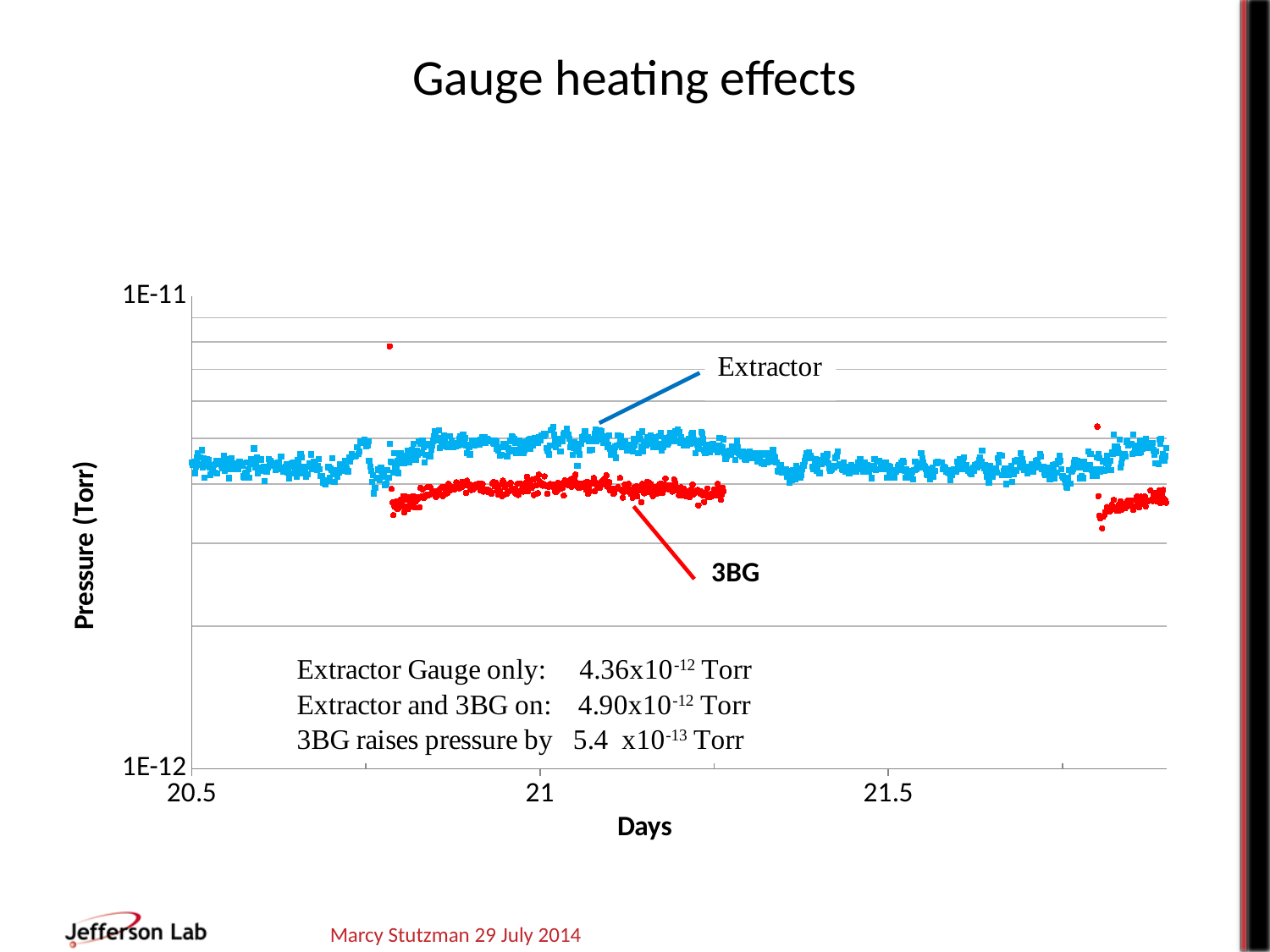
According to the text on the chart, by how much does the 3BG raise the pressure? 5.4 x10^-13 Torr What is the label of the x axis? Days What is the label of the y axis? Pressure (Torr) Is the pressure for the Extractor series greater or less than 1E-12 Torr? greater How many data series are plotted on the chart? 2 According to the text on the chart, what is the pressure with the Extractor Gauge only? 4.36x10^-12 Torr Which series shows higher pressure values, Extractor or 3BG? Extractor Is the pressure for the 3BG series greater or less than 1E-11 Torr? less What are the names of the two series plotted on the chart? Extractor and 3BG What kind of chart is shown on the slide? scatter chart According to the text on the chart, what is the pressure with the Extractor and 3BG on? 4.90x10^-12 Torr